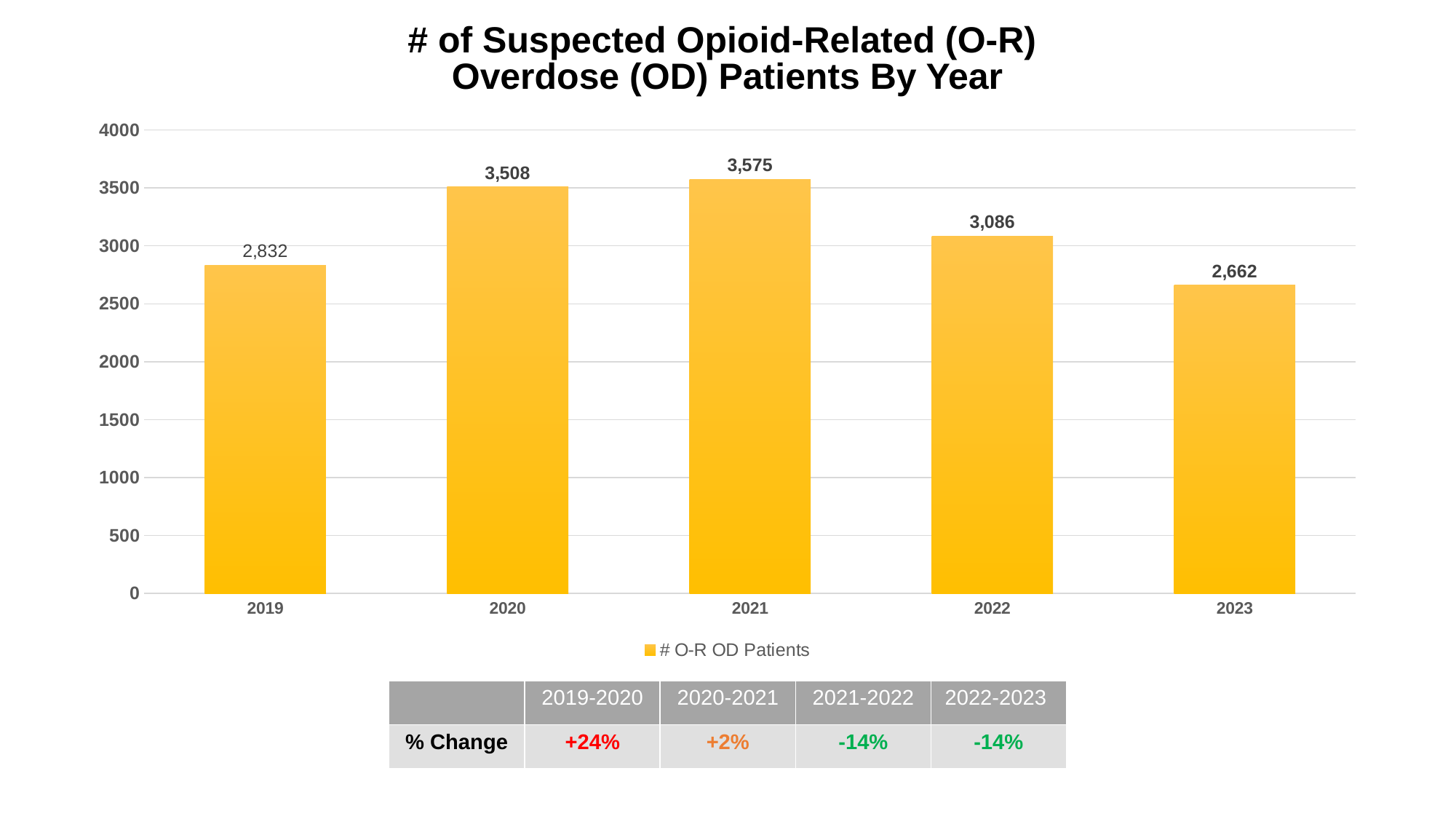
How many years are shown on the x axis? 5 What is the difference in O-R OD patients between 2022 and 2023? 424 What is the difference in O-R OD patients between 2020 and 2019? 676 What is the number of O-R OD patients in 2023? 2,662 Which year has more O-R OD patients, 2019 or 2022? 2022 What kind of chart is shown on the slide? Bar chart Is the value for 2022 greater or less than 3000? greater What is the number of O-R OD patients in 2021? 3,575 What is the number of O-R OD patients in 2019? 2,832 What is the series name shown in the legend? # O-R OD Patients Which year has the highest number of O-R OD patients? 2021 Which year has the lowest number of O-R OD patients? 2023